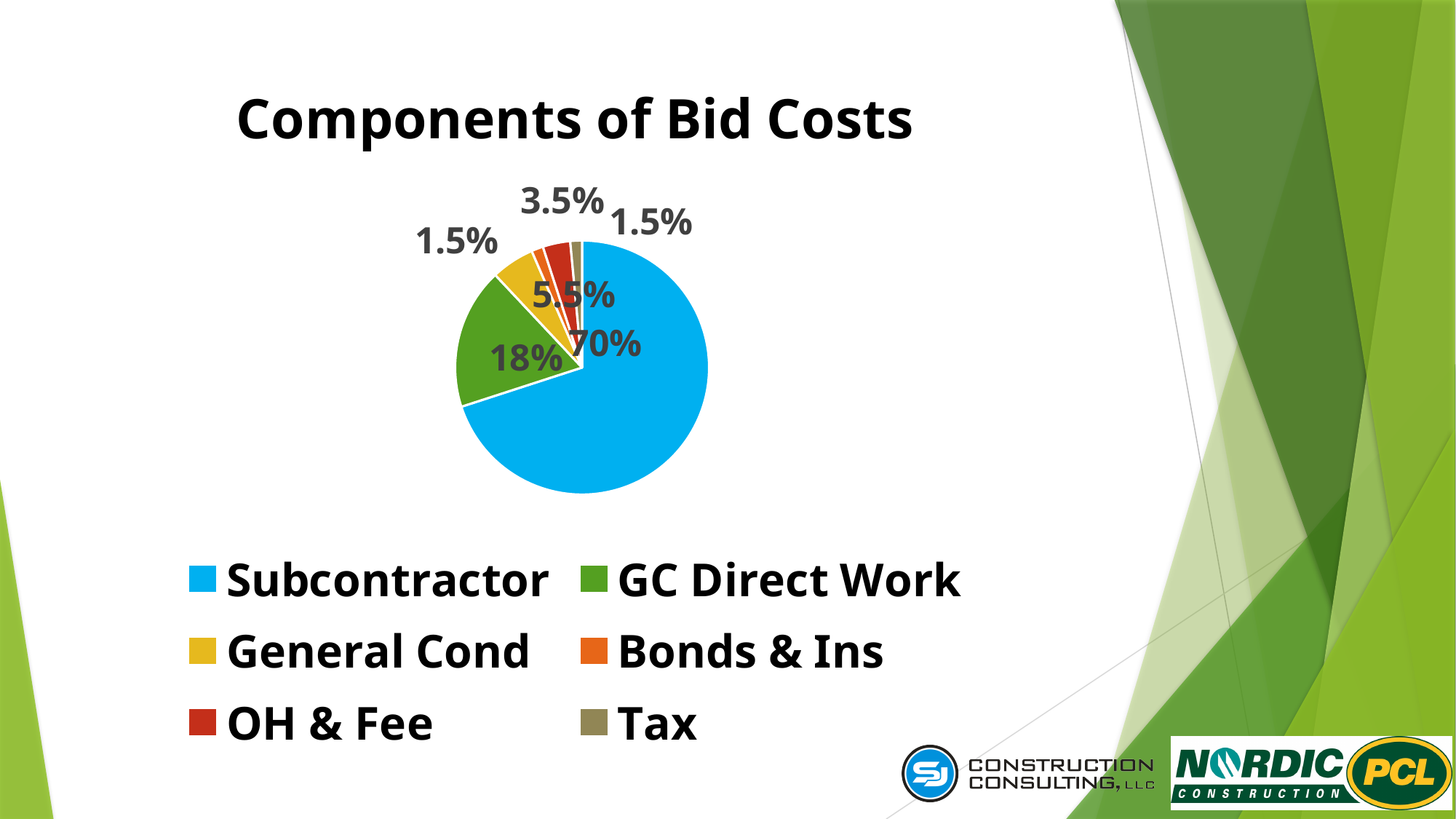
Which is larger, the share for General Cond or the share for OH & Fee? General Cond What percentage of bid costs is attributed to Tax? 1.5% Which component makes up the largest share of bid costs? Subcontractor What percentage of bid costs is attributed to OH & Fee? 3.5% What type of chart is shown on the slide? Pie chart What is the difference in percentage points between Subcontractor and GC Direct Work? 52 What percentage of bid costs is attributed to General Cond? 5.5% What percentage of bid costs is attributed to GC Direct Work? 18% How many components are shown in the pie chart? 6 What is the title of the chart? Components of Bid Costs What percentage of bid costs is attributed to Subcontractor? 70% Which colour represents Subcontractor in the legend? Blue